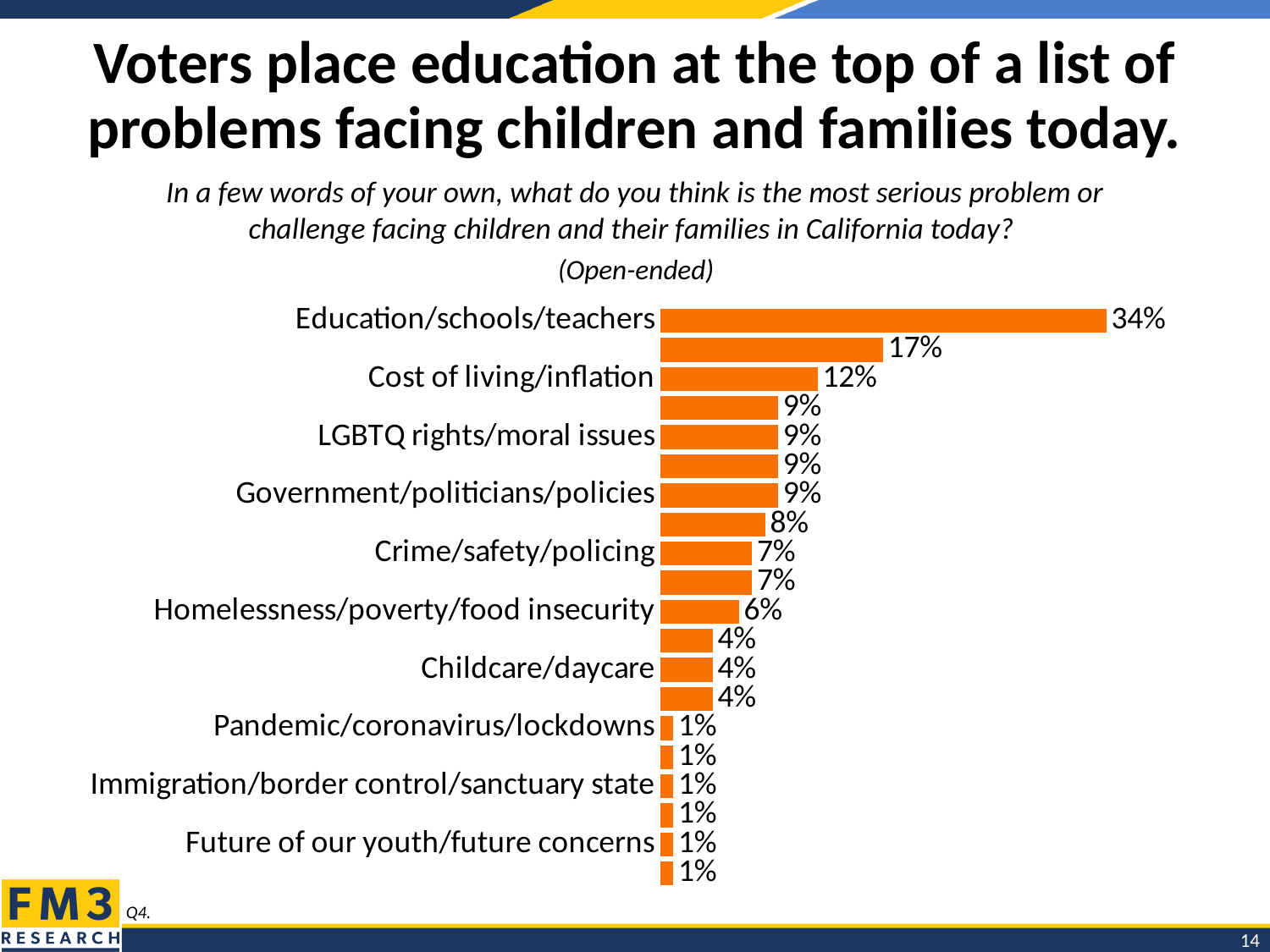
What percentage of voters named Education/schools/teachers as the most serious problem? 34% What colour are the bars on the chart? Orange What is the value shown for Crime/safety/policing? 7% What is the value shown for Homelessness/poverty/food insecurity? 6% How many bars are plotted on the chart? 20 What type of chart is shown on the slide? Bar chart What is the difference between the values for Education/schools/teachers and Cost of living/inflation? 22% Which labeled category has the highest value on the chart? Education/schools/teachers Which is larger, the value for LGBTQ rights/moral issues or the value for Crime/safety/policing? LGBTQ rights/moral issues What is the value shown for Cost of living/inflation? 12% What is the value shown for Childcare/daycare? 4% What is the value shown for Immigration/border control/sanctuary state? 1%